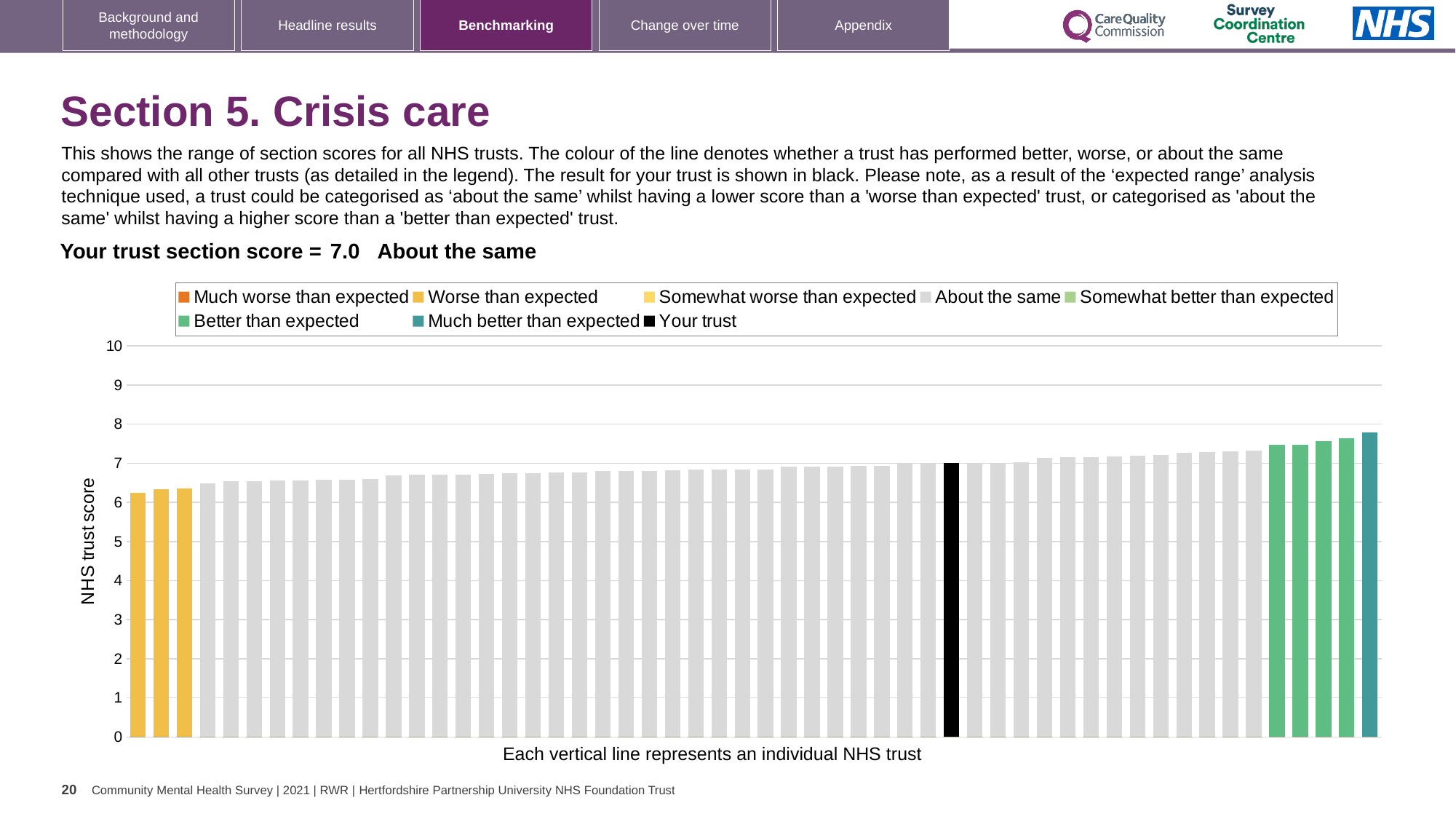
How many bars are coloured as 'Worse than expected'? 3 What is the label on the vertical axis of the chart? NHS trust score What colour is the bar representing your trust? Black Is the value of the shortest bar greater or less than 5? greater Is the value of the tallest bar greater or less than 8? less Which category is your trust placed in for this section? About the same How many entries does the chart legend list? 8 Do the bar values rise or fall from left to right along the x axis? Rise Is the value of the black bar (your trust) greater or less than 5? greater Which is taller: the black bar for your trust or the leftmost bar? The black bar for your trust What kind of chart is shown on the slide? Bar chart What is the section score for your trust shown on the slide? 7.0